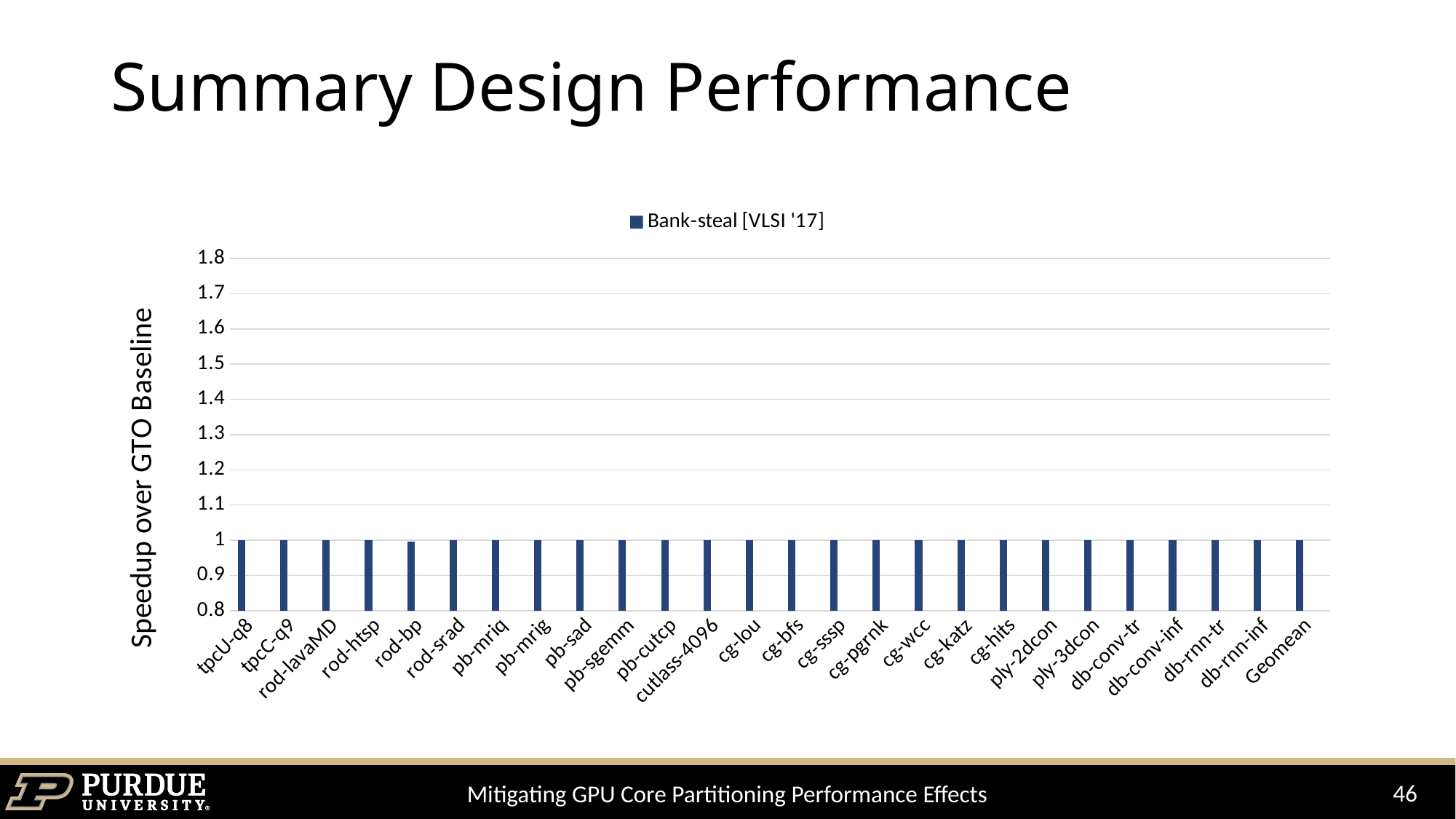
What kind of chart is shown on the slide? bar chart Is the value for cg-bfs greater or less than 1.4? less Do the values rise, fall, or stay roughly flat across the categories along the x axis? stay roughly flat Is the value for pb-sgemm greater or less than 0.8? greater What is the label of the vertical axis? Speedup over GTO Baseline What is the highest value shown on the vertical axis? 1.8 What is the name of the series shown in the legend? Bank-steal [VLSI '17] Is the value for Geomean greater or less than 1.2? less How many categories are plotted along the x axis? 26 How many series does the legend list? 1